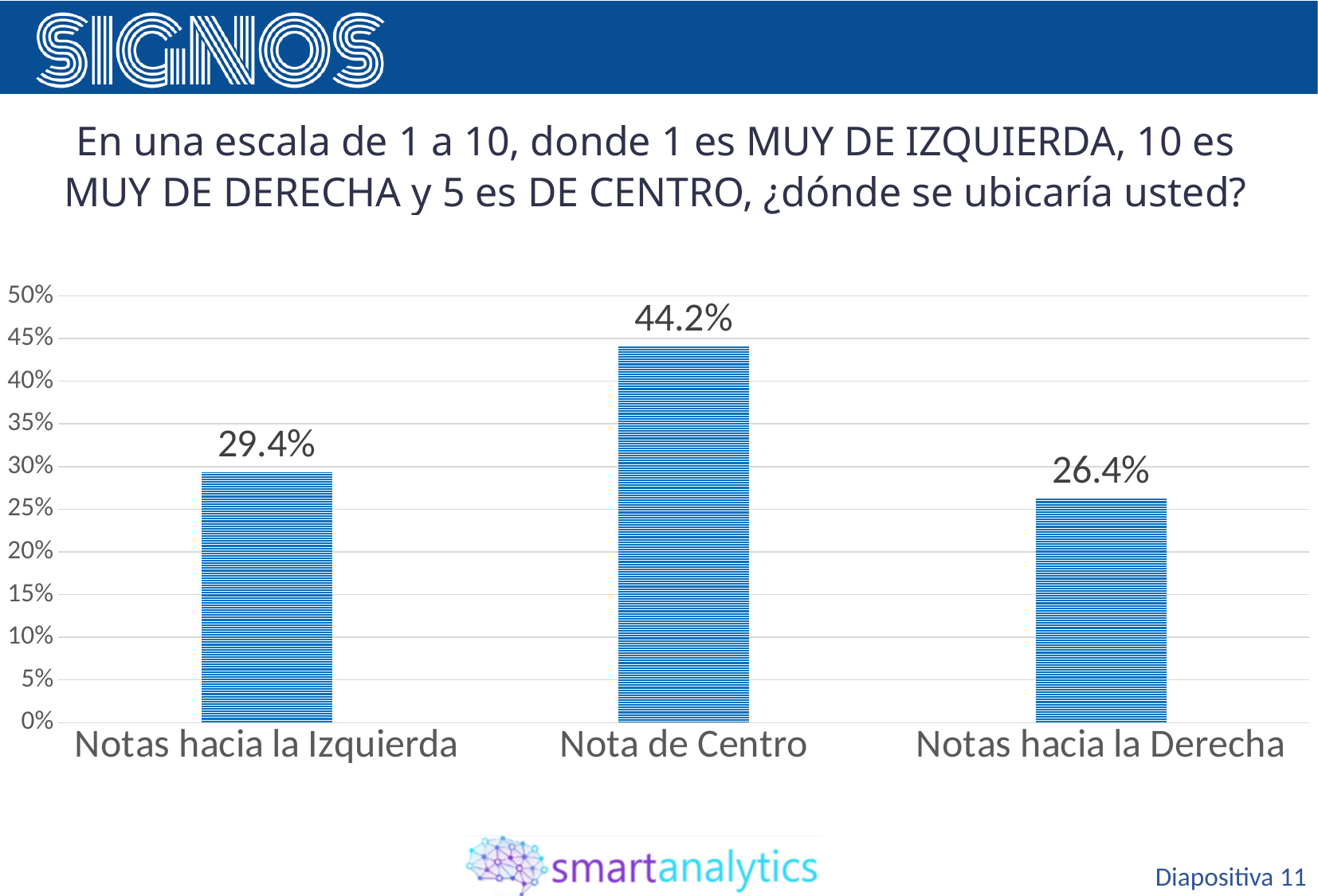
Is the value for Nota de Centro greater or less than 40%? greater Which category has the highest value? Nota de Centro Which category has the lowest value? Notas hacia la Derecha What is the difference between Notas hacia la Izquierda and Notas hacia la Derecha? 3.0% Which is larger, Notas hacia la Izquierda or Notas hacia la Derecha? Notas hacia la Izquierda What is the highest value shown on the vertical axis? 50% What kind of chart is shown on the slide? Bar chart What is the value for Nota de Centro? 44.2% How many categories are shown in the chart? 3 What is the difference between Nota de Centro and Notas hacia la Izquierda? 14.8% What is the value for Notas hacia la Derecha? 26.4% What is the value for Notas hacia la Izquierda? 29.4%